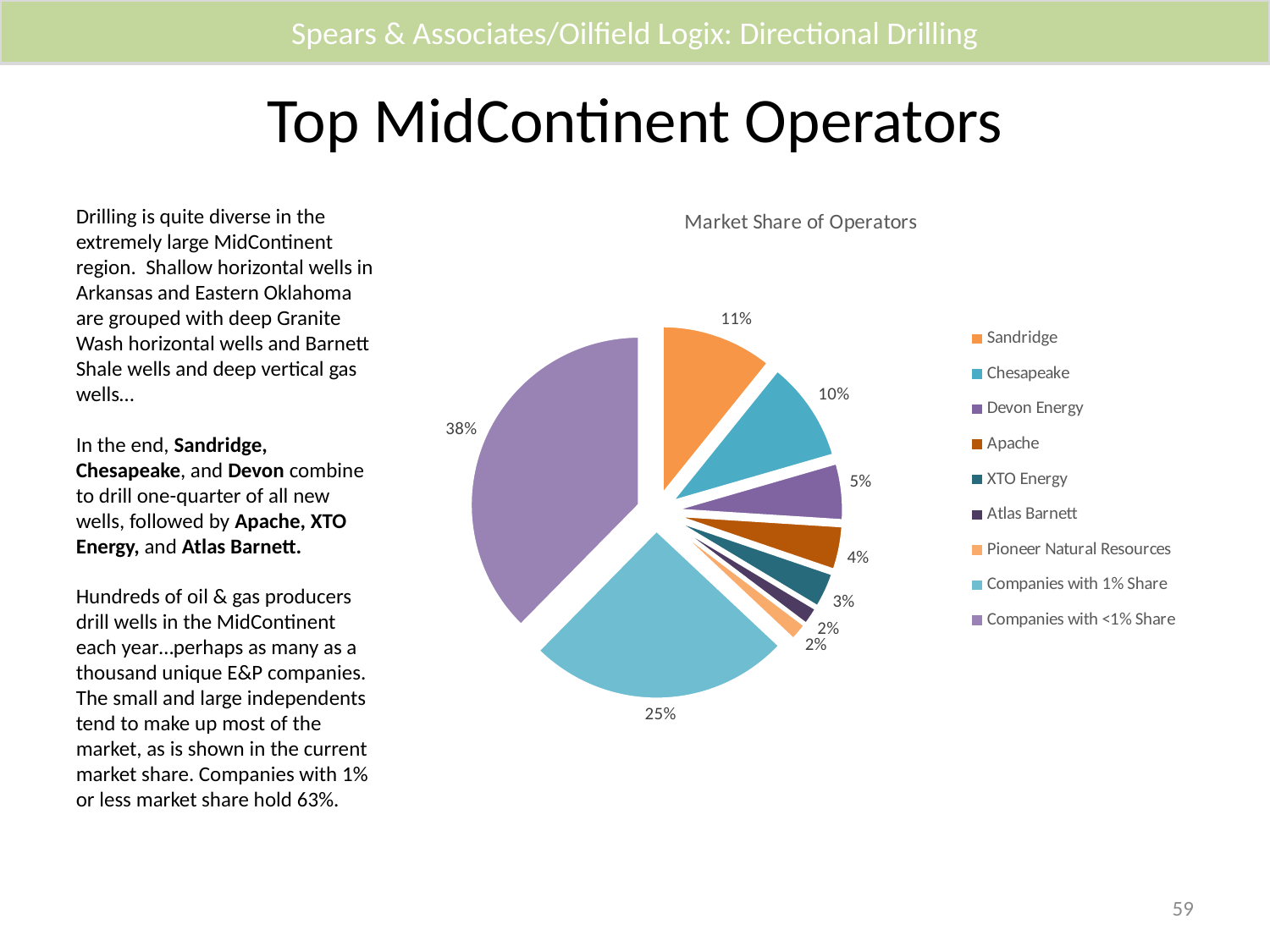
What is the title of the chart? Market Share of Operators What share of the pie does Apache hold? 4% What share of the pie do Companies with <1% Share hold? 38% How many categories does the legend list? 9 What share of the pie does Chesapeake hold? 10% What type of chart is shown on the slide? pie chart Which is larger, the share for Sandridge or the share for Chesapeake? Sandridge Which category has the largest slice of the pie? Companies with <1% Share What is the difference in percentage points between the share for Companies with <1% Share and the share for Companies with 1% Share? 13